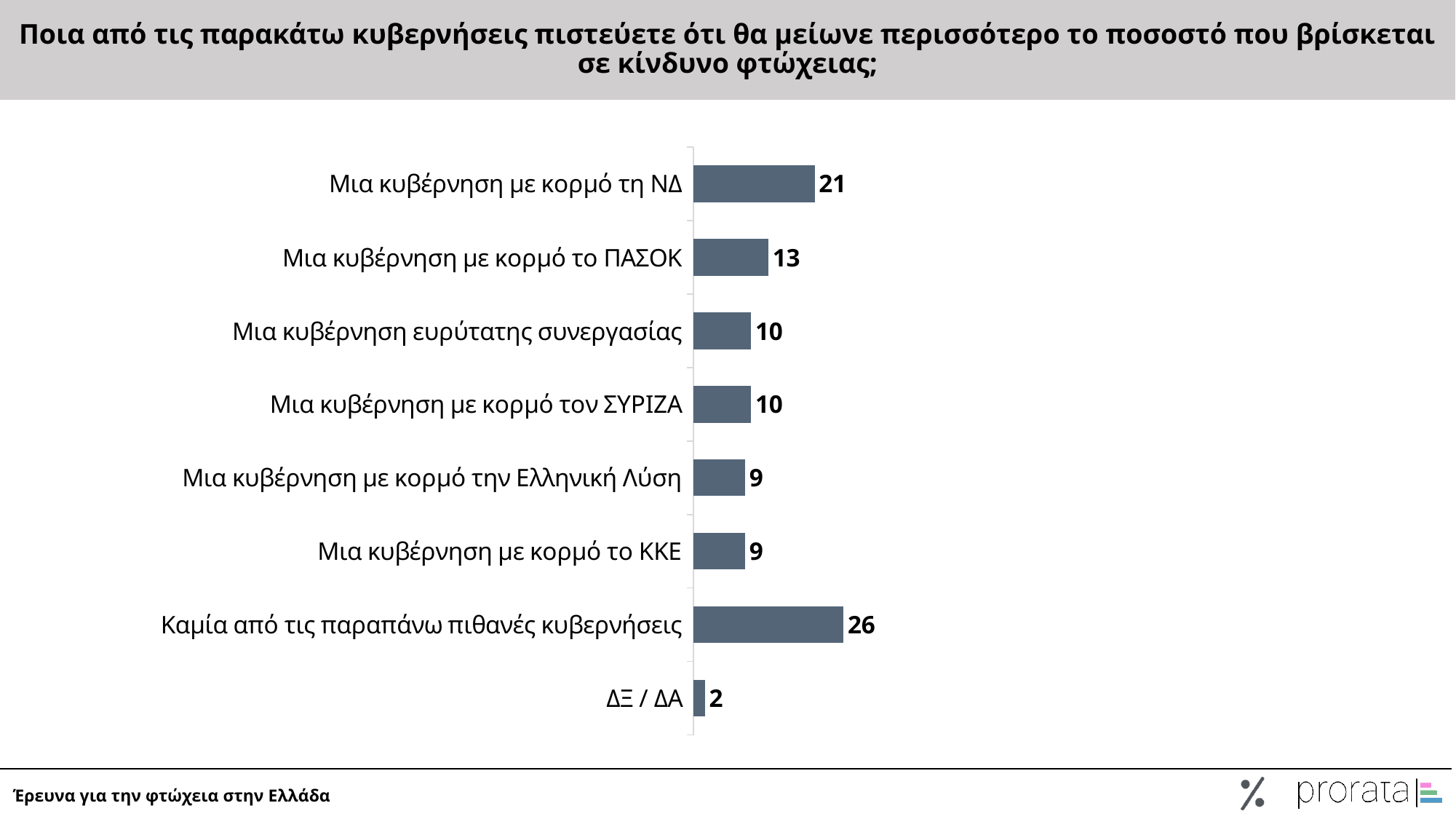
What is the value for "Μια κυβέρνηση με κορμό τη ΝΔ"? 21 What is the value for "Μια κυβέρνηση με κορμό το ΠΑΣΟΚ"? 13 How many categories are shown in the chart? 8 What is the value for "Μια κυβέρνηση με κορμό το ΚΚΕ"? 9 Which category has the highest value? Καμία από τις παραπάνω πιθανές κυβερνήσεις What is the difference between the values for "Μια κυβέρνηση με κορμό τη ΝΔ" and "Μια κυβέρνηση με κορμό το ΠΑΣΟΚ"? 8 Which is larger: the value for "Μια κυβέρνηση με κορμό το ΠΑΣΟΚ" or the value for "Μια κυβέρνηση με κορμό τον ΣΥΡΙΖΑ"? Μια κυβέρνηση με κορμό το ΠΑΣΟΚ What kind of chart is shown on the slide? Bar chart What is the difference between the values for "Καμία από τις παραπάνω πιθανές κυβερνήσεις" and "Μια κυβέρνηση με κορμό τη ΝΔ"? 5 Which category has the lowest value? ΔΞ / ΔΑ What is the value for "Καμία από τις παραπάνω πιθανές κυβερνήσεις"? 26 What is the value for "ΔΞ / ΔΑ"? 2